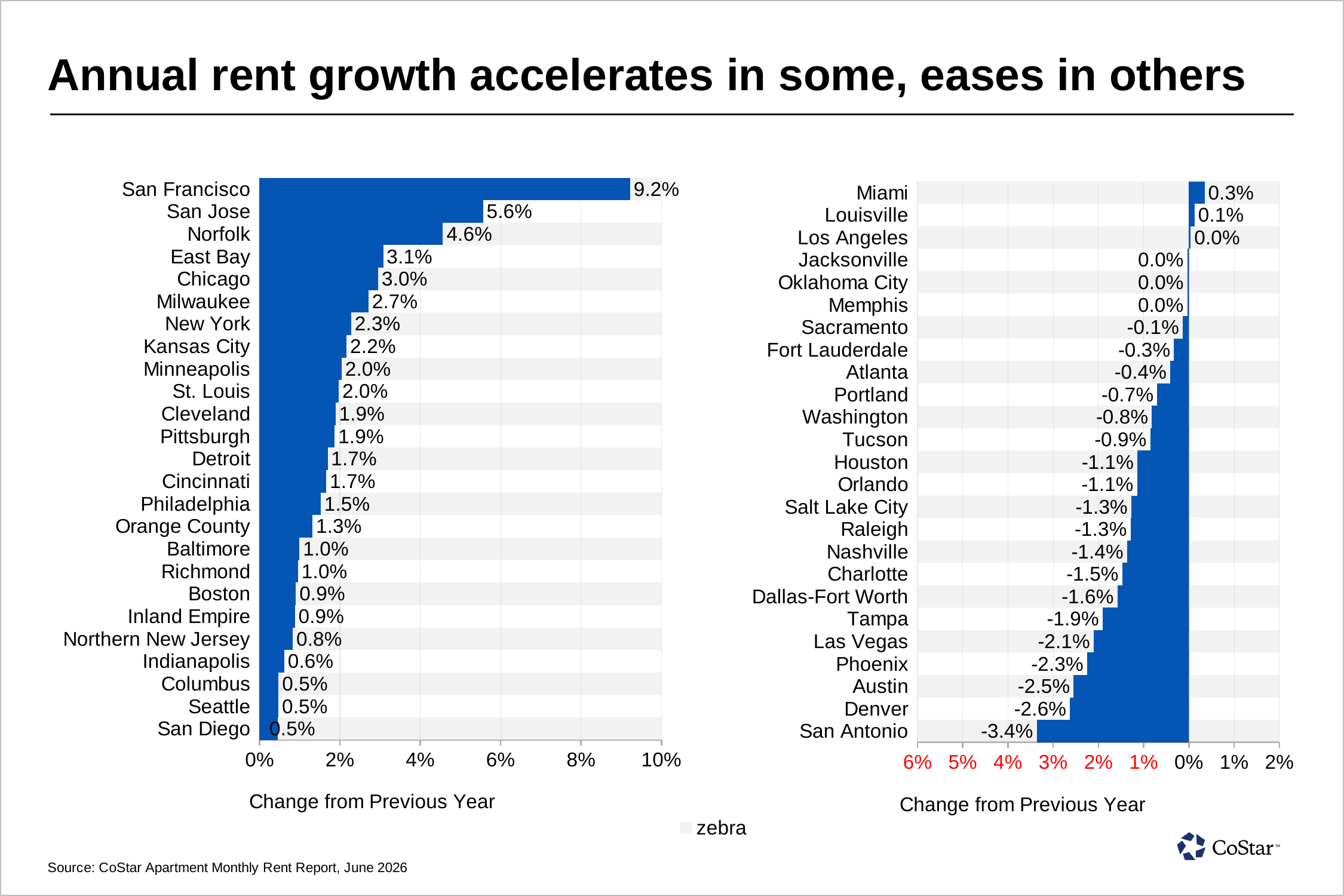
In the right chart, what is the value for Tampa? -1.9% In the left chart, what is the value for San Francisco? 9.2% How many cities are shown in the left chart? 25 In the left chart, which is larger, the value for Norfolk or the value for East Bay? Norfolk What is the x-axis title of the left chart? Change from Previous Year What kind of chart is the right chart? Bar chart In the left chart, what is the value for Milwaukee? 2.7% In the right chart, what is the value for San Antonio? -3.4% In the left chart, what is the difference between San Francisco and San Jose? 3.6% In the left chart, which city has the highest value? San Francisco In the right chart, which city has the lowest value? San Antonio In the right chart, what is the difference between Denver and Phoenix? 0.3%